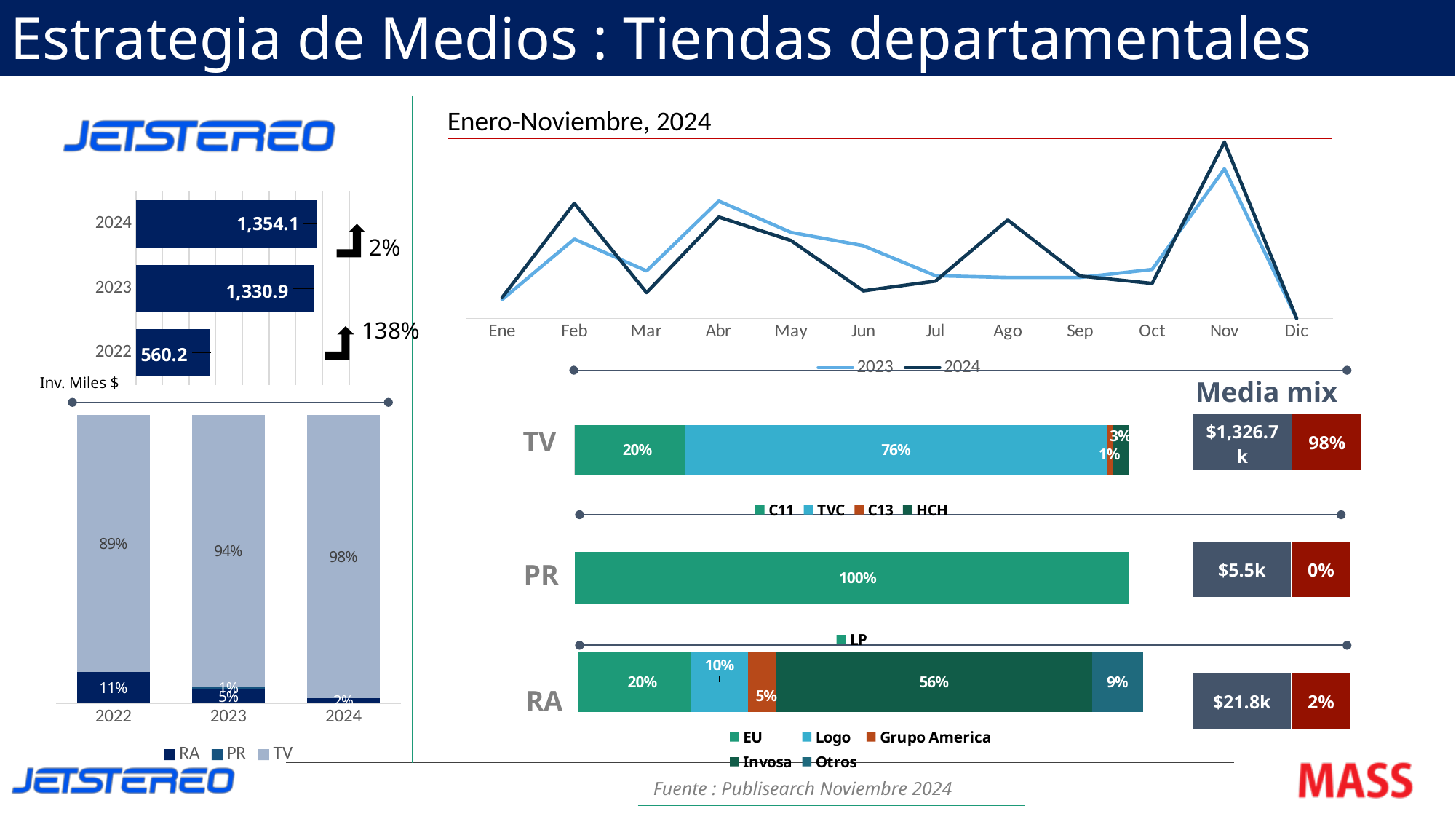
In the top-left bar chart of investment by year, which year has the lowest value? 2022 In the top-left bar chart of investment by year, what is the difference between the 2024 and 2023 values? 23.2 How many series does the legend of the bottom-left stacked bar chart list? 3 In the bottom-left stacked bar chart, what share does RA have in 2022? 11% In the Media mix, what is the amount shown for RA? $21.8k In the top-left bar chart of investment by year, what is the value for 2022? 560.2 In the RA stacked bar, which channel has the largest share? Invosa In the top-left bar chart of investment by year, what is the value for 2024? 1,354.1 In the bottom-left stacked bar chart, what share does TV have in 2023? 94% How many months are shown on the x axis of the line chart? 12 In the TV stacked bar, what share does TVC have? 76% In the line chart for Enero-Noviembre 2024, in which month do both series reach their highest point? Nov